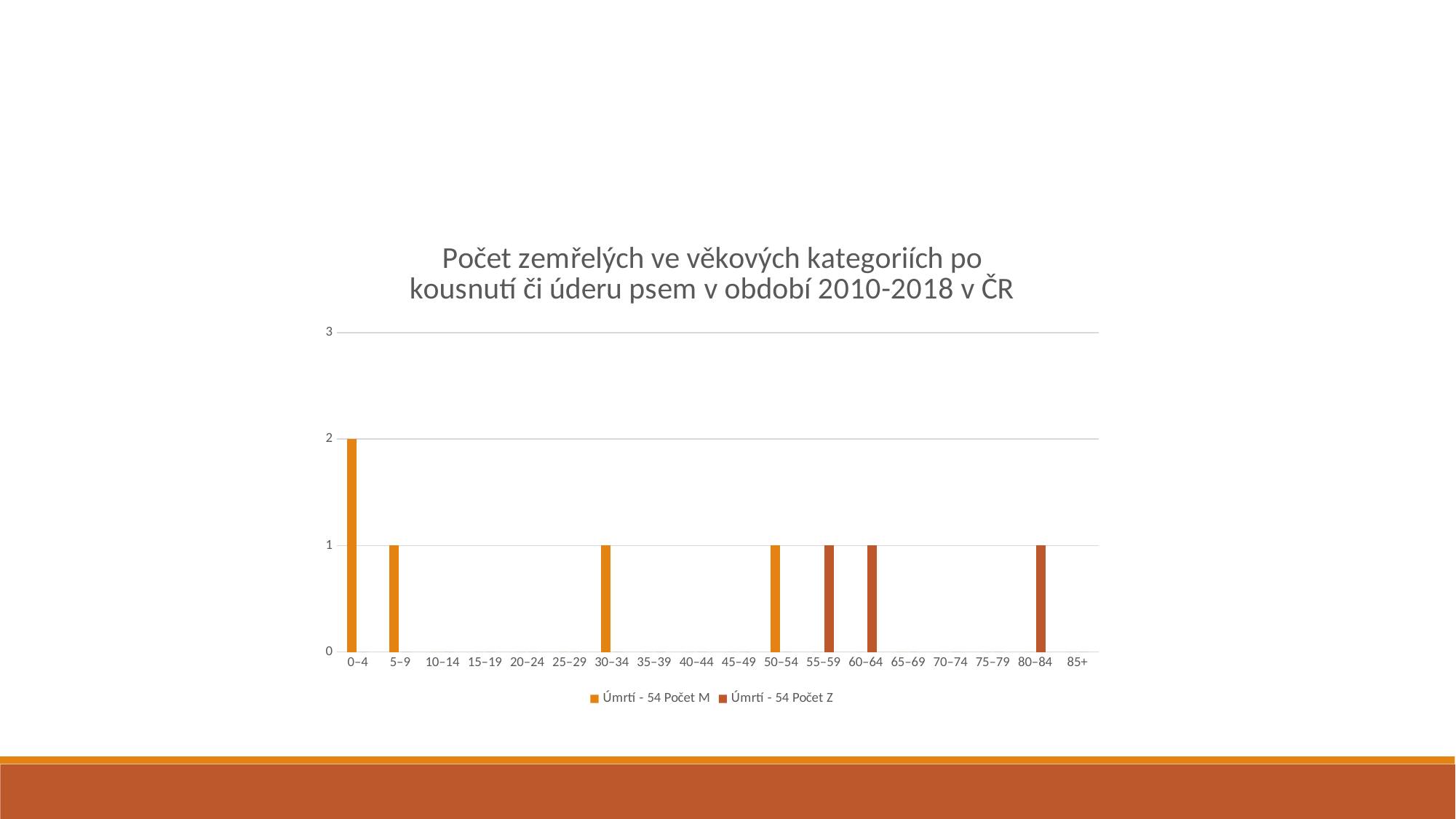
Is the value for the 0–4 age group in the series Úmrtí - 54 Počet M greater or less than 1? greater How many series does the legend list? 2 What kind of chart is shown on the slide? bar chart What is the value for the 5–9 age group in the series Úmrtí - 54 Počet M? 1 What is the highest value shown on the vertical axis? 3 Which is larger: the Úmrtí - 54 Počet M value for 0–4 or the Úmrtí - 54 Počet Z value for 55–59? Úmrtí - 54 Počet M value for 0–4 What is the value for the 0–4 age group in the series Úmrtí - 54 Počet M? 2 How many age categories are shown on the x axis? 18 What is the difference between the Úmrtí - 54 Počet M value for 0–4 and for 30–34? 1 What is the value for the 80–84 age group in the series Úmrtí - 54 Počet Z? 1 What is the title of the chart? Počet zemřelých ve věkových kategoriích po kousnutí či úderu psem v období 2010-2018 v ČR Which age category has the highest value in the series Úmrtí - 54 Počet M? 0–4